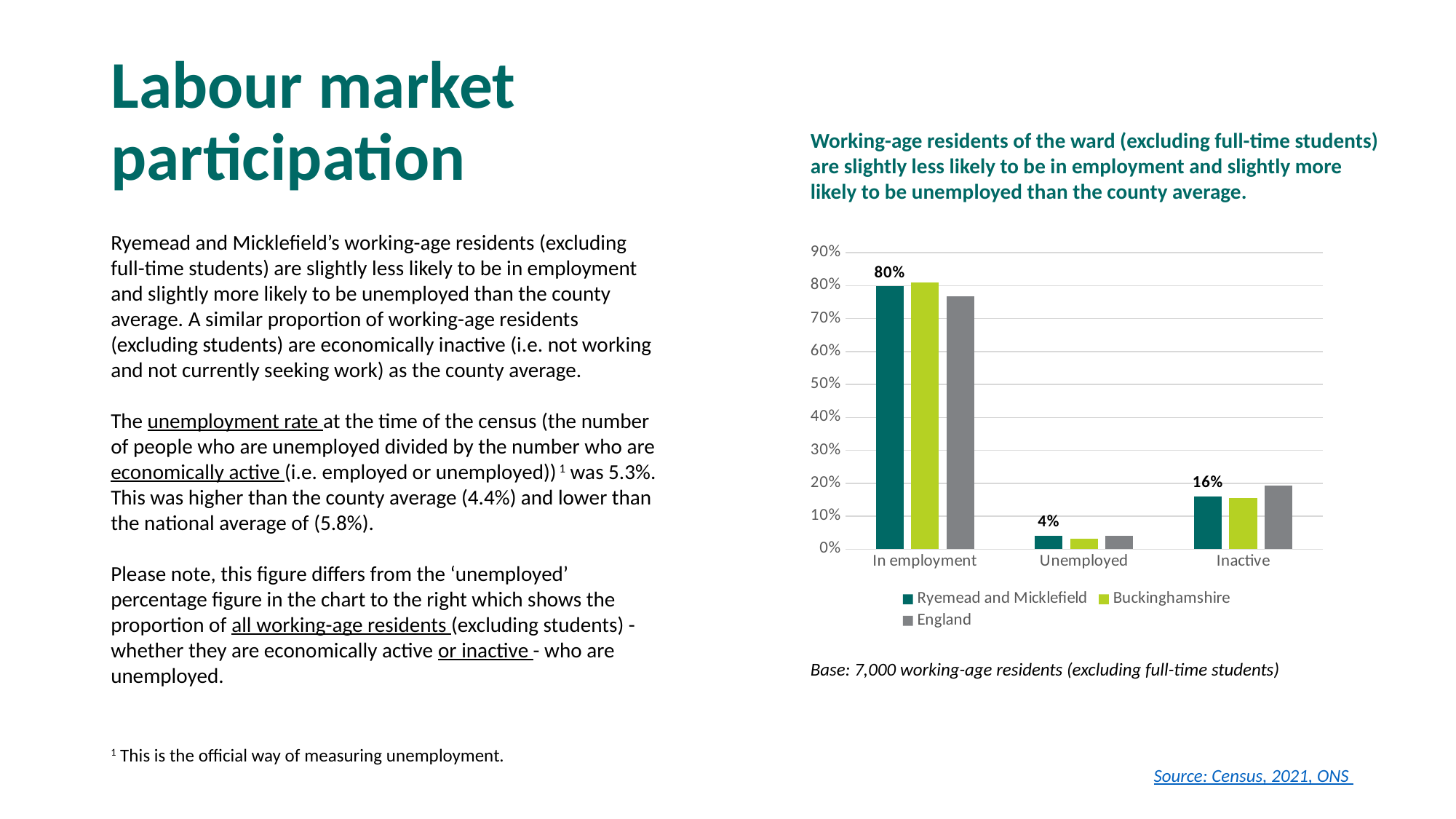
What is the value for Ryemead and Micklefield in the Unemployed category? 4% In the In employment category, which is larger: Buckinghamshire or England? Buckinghamshire In the Inactive category, which is larger: England or Buckinghamshire? England How many series does the chart legend list? 3 How many categories are shown on the x axis of the chart? 3 What is the value for Ryemead and Micklefield in the Inactive category? 16% What percentage of Ryemead and Micklefield working-age residents are in employment? 80% What type of chart is shown on the slide? Bar chart Which category has the lowest value for Ryemead and Micklefield? Unemployed What is the difference between the Ryemead and Micklefield values for In employment and Inactive? 64 percentage points Which category has the highest value for Ryemead and Micklefield? In employment Is the value for England in the In employment category greater or less than 80%? less